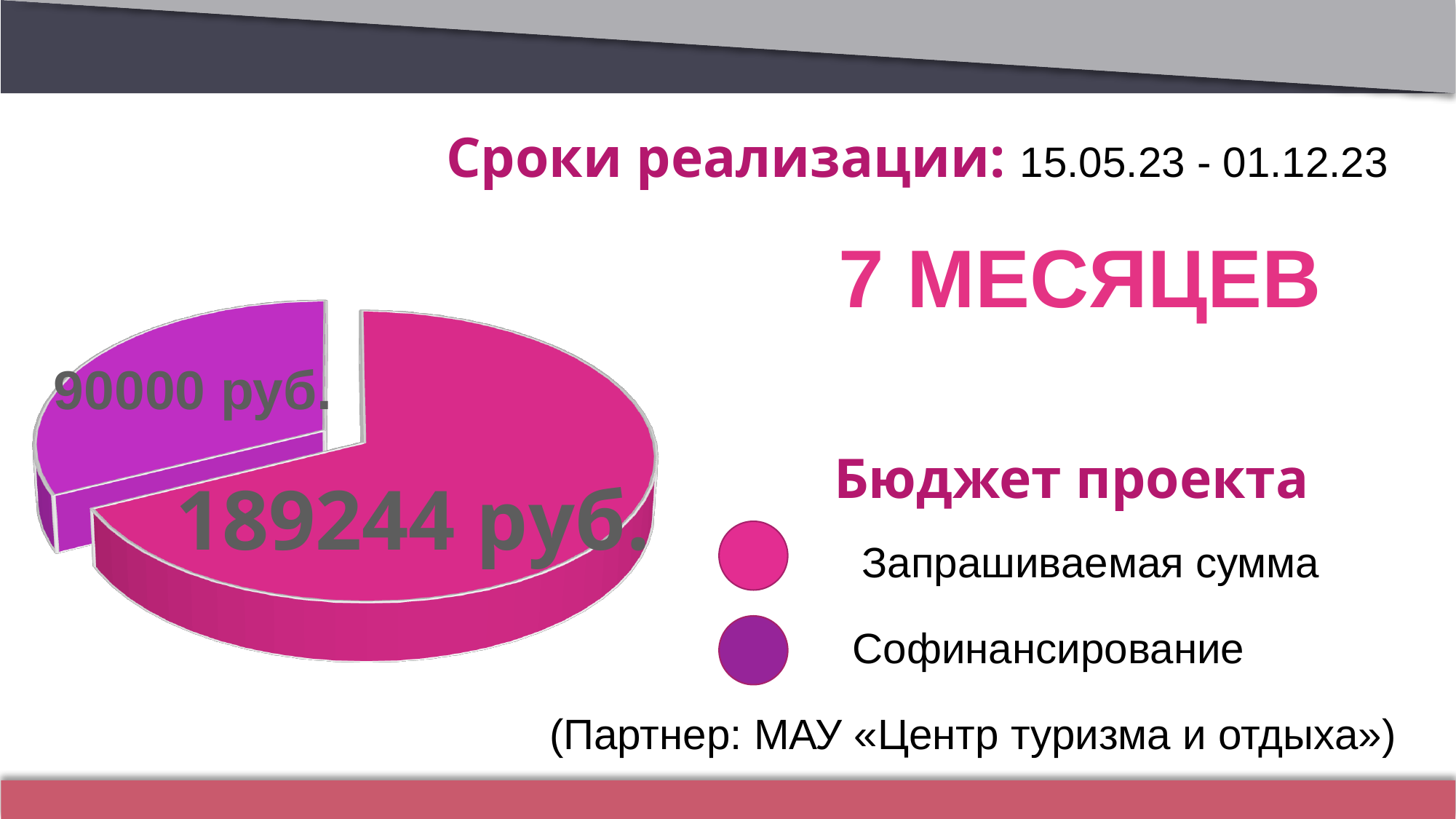
What is the difference between Запрашиваемая сумма and Софинансирование? 99244 руб. What is the value of the Запрашиваемая сумма slice? 189244 руб. Which slice of the pie is the smallest? Софинансирование What kind of chart is shown on the slide? pie chart Which slice of the pie is the largest? Запрашиваемая сумма What is the total of the two slices in the pie chart? 279244 руб. How many entries does the legend list? 2 How many slices does the pie chart have? 2 What is the title of the chart? Бюджет проекта Which is larger, Запрашиваемая сумма or Софинансирование? Запрашиваемая сумма What colour is the Софинансирование slice? purple What is the value of the Софинансирование slice? 90000 руб.